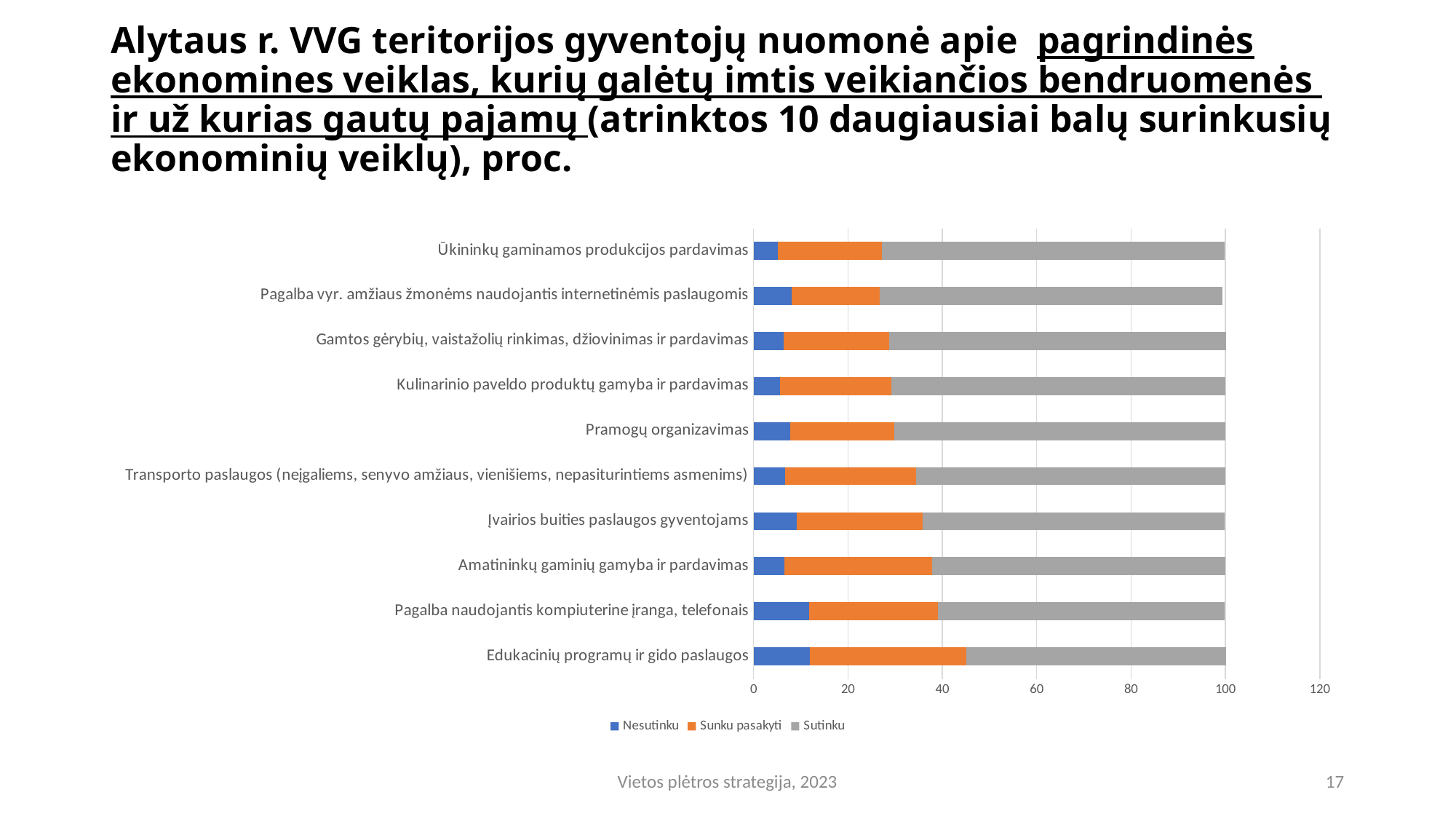
What kind of chart is shown on the slide? bar chart Which has the larger 'Nesutinku' value: 'Edukacinių programų ir gido paslaugos' or 'Ūkininkų gaminamos produkcijos pardavimas'? Edukacinių programų ir gido paslaugos Which has the larger 'Sutinku' segment: 'Ūkininkų gaminamos produkcijos pardavimas' or 'Edukacinių programų ir gido paslaugos'? Ūkininkų gaminamos produkcijos pardavimas How many economic activities (categories) are listed on the chart? 10 Which category has the smallest 'Sutinku' segment? Edukacinių programų ir gido paslaugos What are the three series named in the legend? Nesutinku, Sunku pasakyti, Sutinku Going from the top category to the bottom category, does the 'Sutinku' segment generally get larger or smaller? smaller Is the 'Nesutinku' value for 'Ūkininkų gaminamos produkcijos pardavimas' greater or less than 20? less Which category has the largest 'Sunku pasakyti' segment? Edukacinių programų ir gido paslaugos Which colour represents the 'Sutinku' series? grey Is the 'Nesutinku' value for 'Edukacinių programų ir gido paslaugos' greater or less than 20? less How many series does the chart legend list? 3